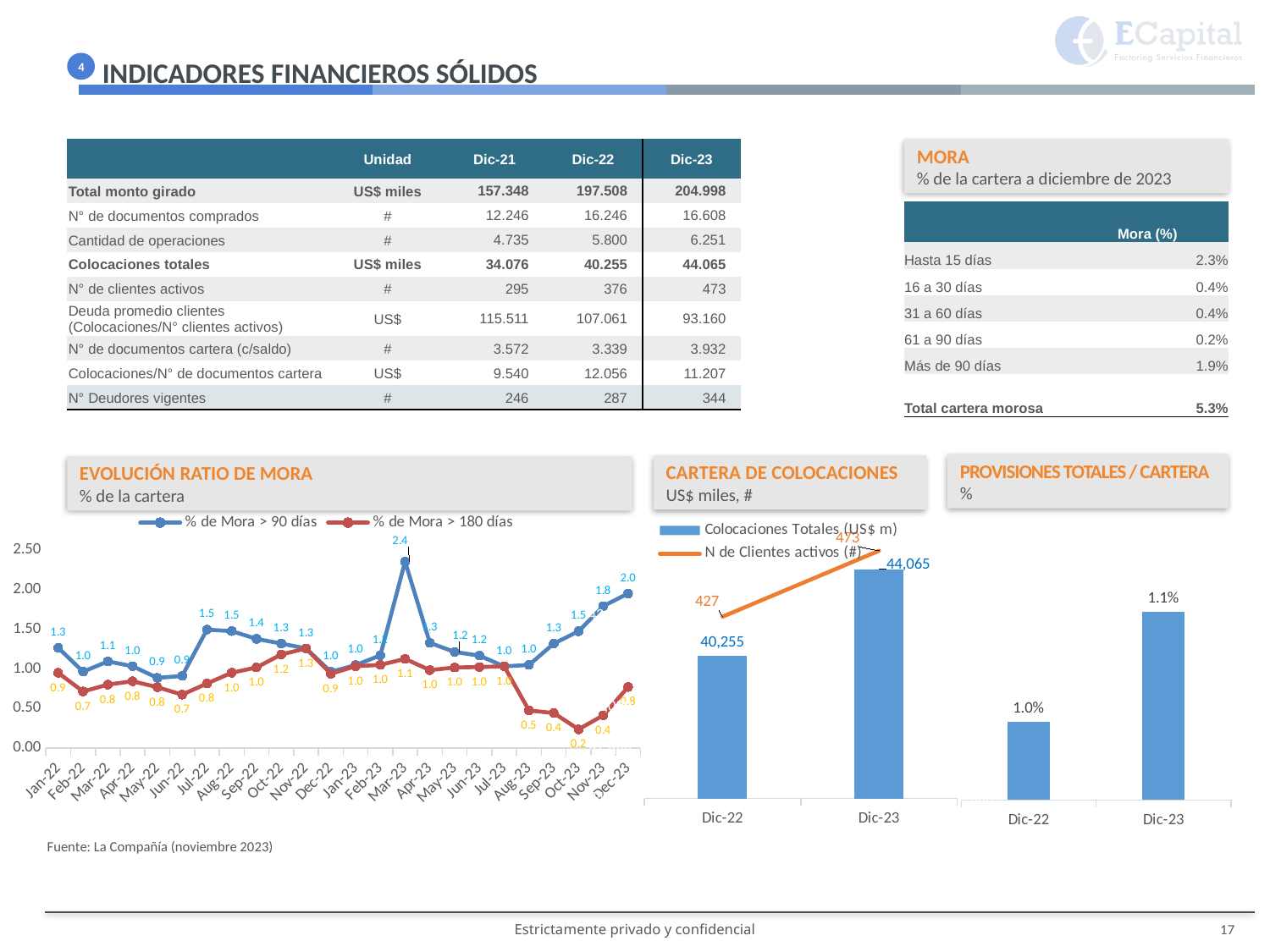
In the 'CARTERA DE COLOCACIONES' chart, what is the value of Colocaciones Totales for Dic-22? 40,255 How many series does the legend of the 'CARTERA DE COLOCACIONES' chart list? 2 In the 'EVOLUCIÓN RATIO DE MORA' chart, what is the value of '% de Mora > 90 días' for Dec-23? 2.0 In the 'EVOLUCIÓN RATIO DE MORA' chart, which month has the highest value for '% de Mora > 90 días'? Mar-23 In the 'CARTERA DE COLOCACIONES' chart, what is the value of N de Clientes activos for Dic-23? 473 What kind of chart is the 'PROVISIONES TOTALES / CARTERA' chart? bar chart In the 'PROVISIONES TOTALES / CARTERA' chart, do the values rise or fall from Dic-22 to Dic-23? rise In the 'CARTERA DE COLOCACIONES' chart, what is the value of Colocaciones Totales for Dic-23? 44,065 In the 'PROVISIONES TOTALES / CARTERA' chart, what is the value for Dic-23? 1.1% In the 'CARTERA DE COLOCACIONES' chart, what is the difference between Colocaciones Totales for Dic-23 and Dic-22? 3,810 In the 'EVOLUCIÓN RATIO DE MORA' chart, which month has the lowest value for '% de Mora > 180 días'? Oct-23 In the 'PROVISIONES TOTALES / CARTERA' chart, what is the value for Dic-22? 1.0%